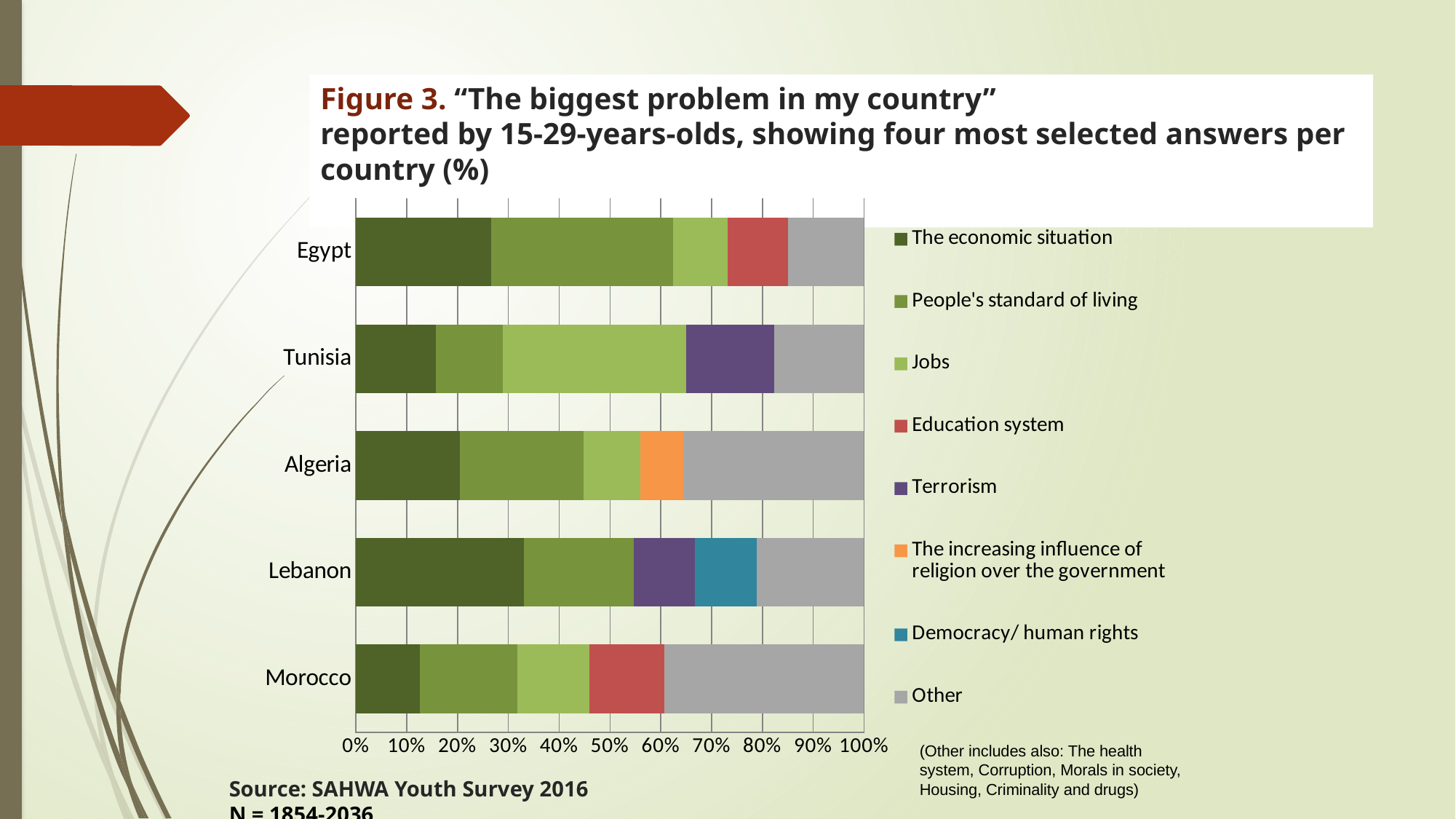
Is the 'Jobs' segment for Tunisia greater or less than 30%? greater Which country's bar includes a segment for 'The increasing influence of religion over the government'? Algeria How many series does the legend list? 8 Is the 'The economic situation' segment for Egypt greater or less than 20%? greater Which country has the largest segment for 'Jobs'? Tunisia Which country has the largest segment for 'The economic situation'? Lebanon What kind of chart is shown on the slide? Stacked bar chart Which countries' bars include a 'Terrorism' segment? Tunisia and Lebanon Which is larger: the 'The economic situation' segment for Lebanon or for Morocco? Lebanon Which is larger: the 'The economic situation' segment for Egypt or for Tunisia? Egypt How many countries are shown on the chart? 5 Is the 'Other' segment for Morocco greater or less than 30%? greater